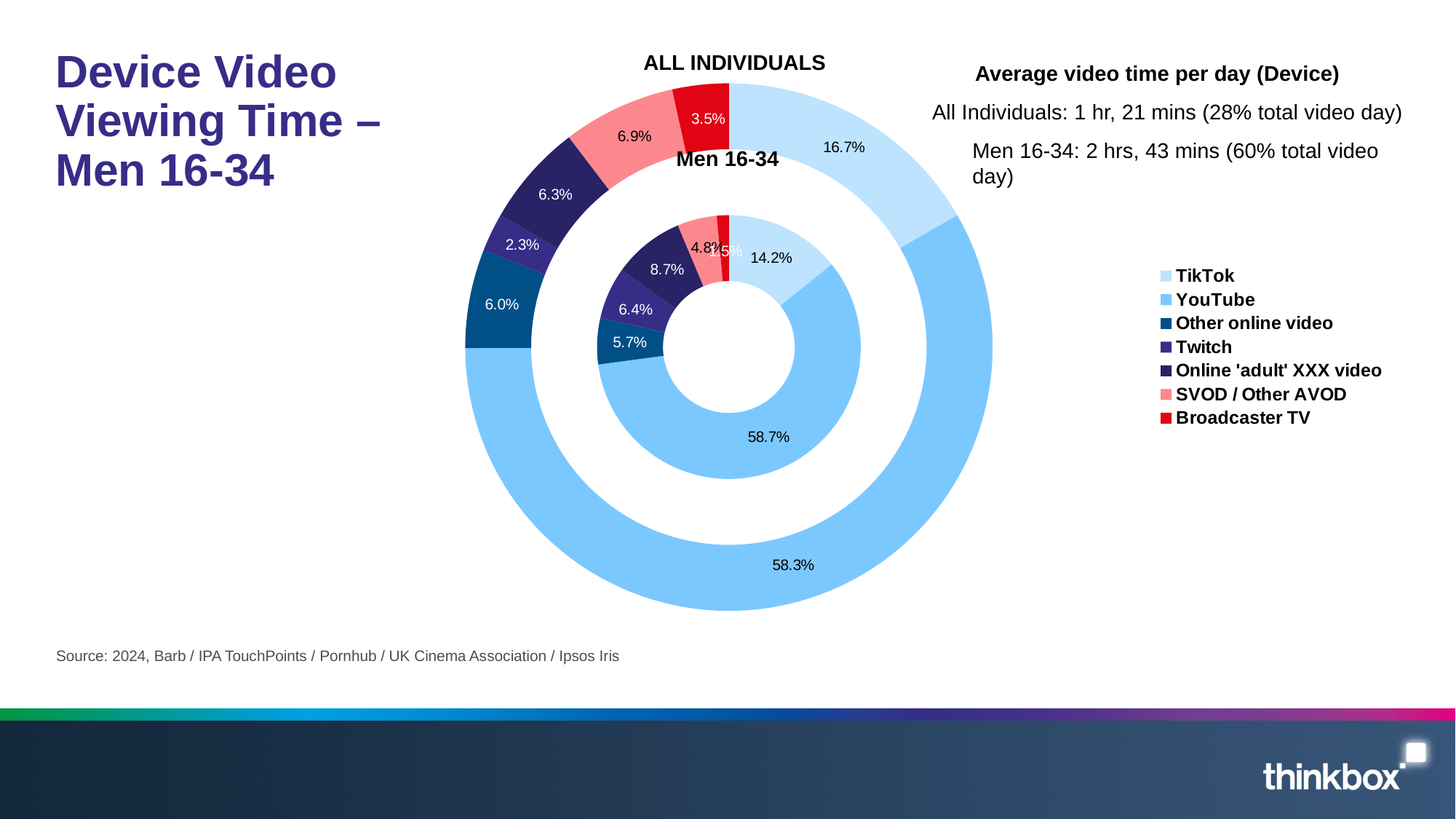
What share of device video viewing time does YouTube account for in the ALL INDIVIDUALS (outer) ring? 58.3% What is the value for Twitch in the ALL INDIVIDUALS ring? 2.3% What kind of chart is shown on the slide? Doughnut chart Which category has the largest share in the ALL INDIVIDUALS ring? YouTube Is the Twitch share larger for ALL INDIVIDUALS or for Men 16-34? Men 16-34 What share of device video viewing time does TikTok account for in the Men 16-34 (inner) ring? 14.2% How many categories does the legend list? 7 Is the SVOD / Other AVOD share larger for ALL INDIVIDUALS or for Men 16-34? ALL INDIVIDUALS What is the value for Online 'adult' XXX video in the Men 16-34 ring? 8.7% What is the difference between the TikTok share for ALL INDIVIDUALS (16.7%) and for Men 16-34 (14.2%)? 2.5 percentage points Which group does the inner ring of the doughnut chart represent? Men 16-34 Which category has the smallest share in the ALL INDIVIDUALS ring? Twitch